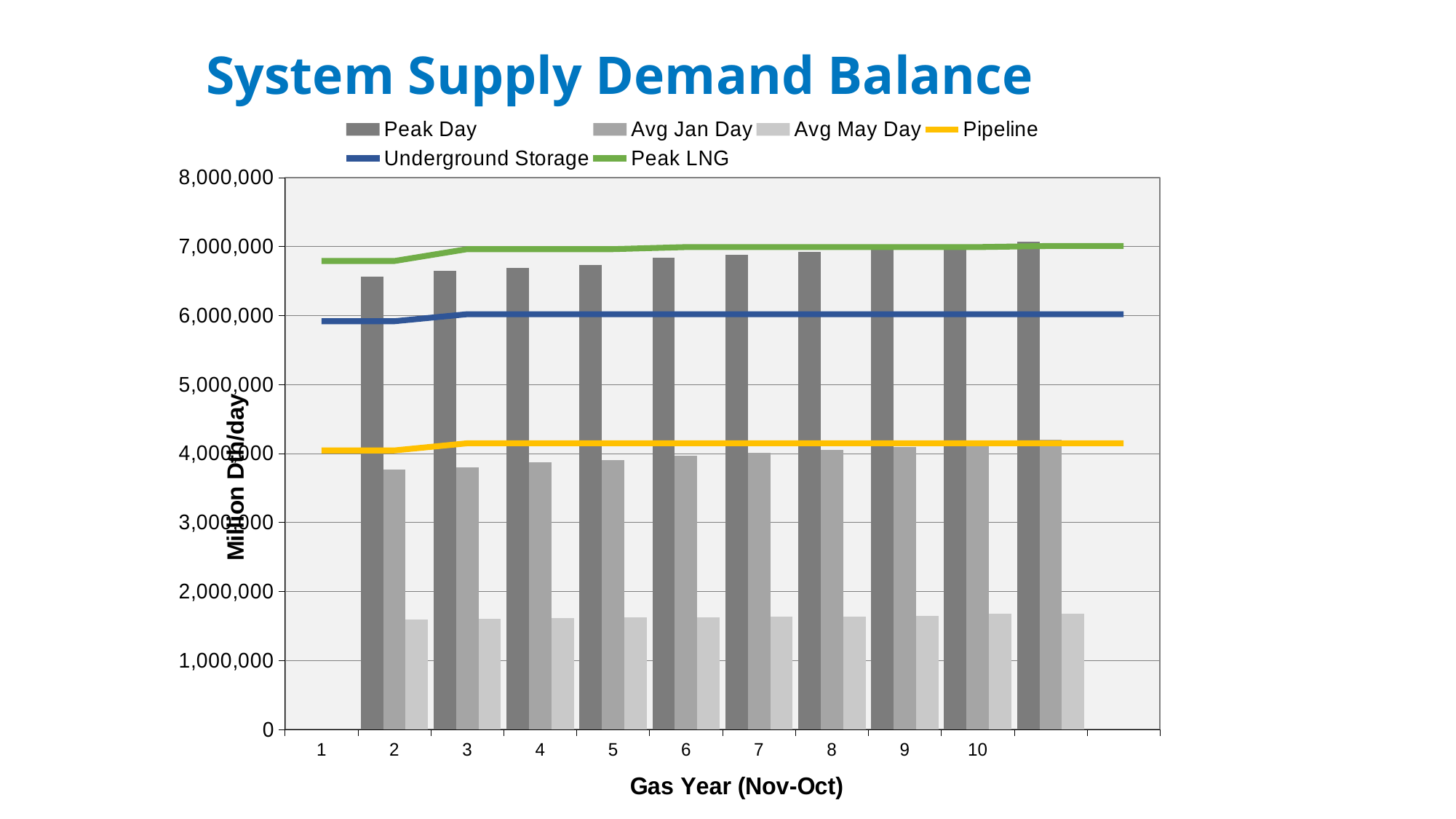
Is the Peak LNG value at gas year 1 greater or less than 6,000,000? greater What kind of chart is this? Combination bar and line chart How many gas years are labelled on the x axis? 10 What is the label on the x axis? Gas Year (Nov-Oct) Which line series is the lowest on the chart: Pipeline, Underground Storage or Peak LNG? Pipeline Which bar series has the tallest bars: Peak Day, Avg Jan Day or Avg May Day? Peak Day How many series does the legend list? 6 Do the Peak Day bars rise or fall from left to right across the gas years? rise Is the Pipeline value at gas year 1 greater or less than 5,000,000? less Which line series is the highest on the chart: Pipeline, Underground Storage or Peak LNG? Peak LNG What is the title of the chart? System Supply Demand Balance Which bar series has the shortest bars: Peak Day, Avg Jan Day or Avg May Day? Avg May Day